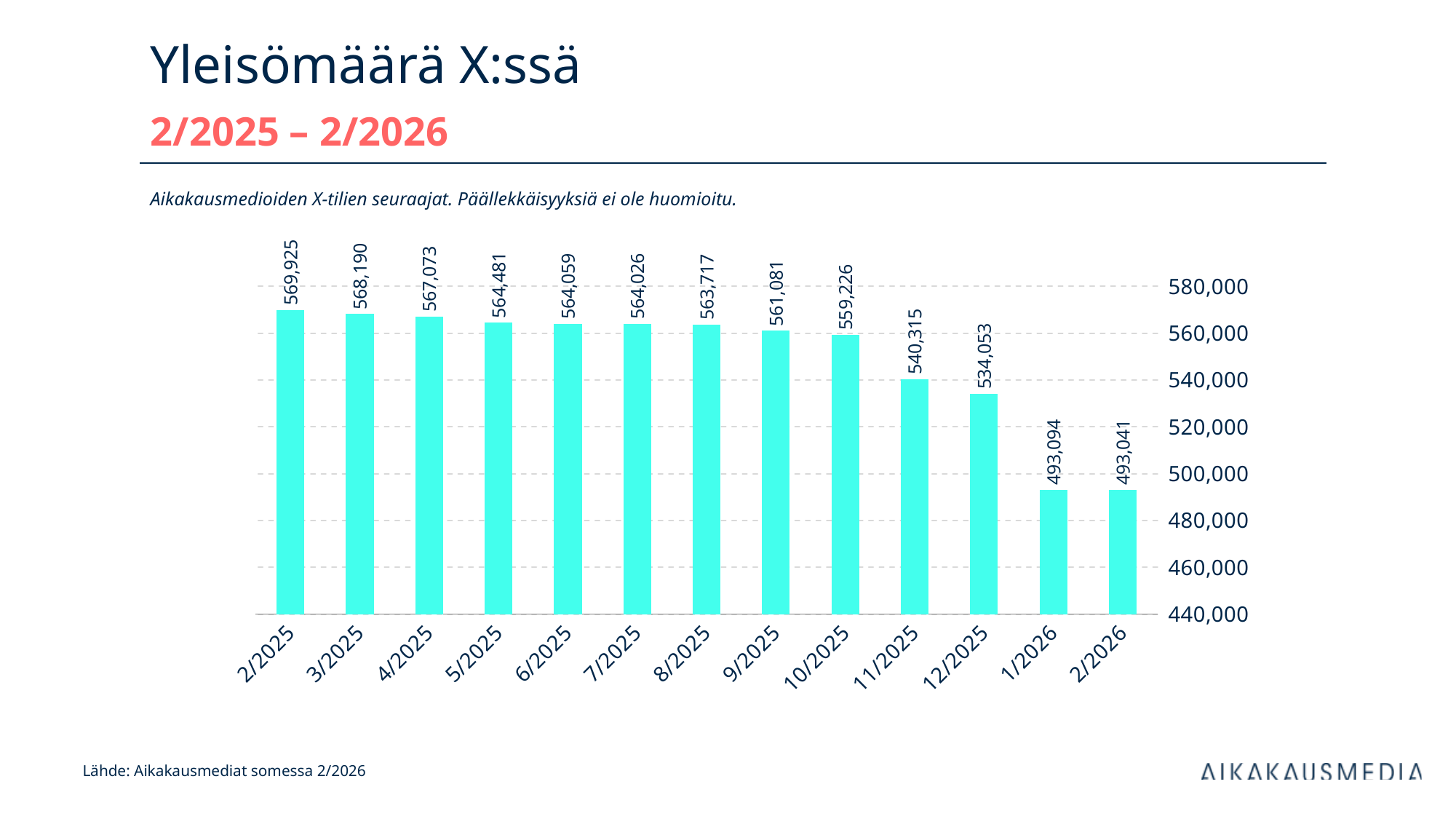
Which month has the highest value? 2/2025 What is the value for 2/2025? 569,925 Which is larger, the value for 9/2025 or the value for 10/2025? 9/2025 Do the values rise or fall from 2/2025 to 2/2026? fall How many months are shown on the x axis? 13 Is the value for 12/2025 greater or less than 540,000? less What is the value for 2/2026? 493,041 What kind of chart is shown on the slide? bar chart What is the difference between the values for 2/2025 and 2/2026? 76,884 What is the value for 11/2025? 540,315 What is the difference between the values for 12/2025 and 1/2026? 40,959 Which month has the lowest value? 2/2026